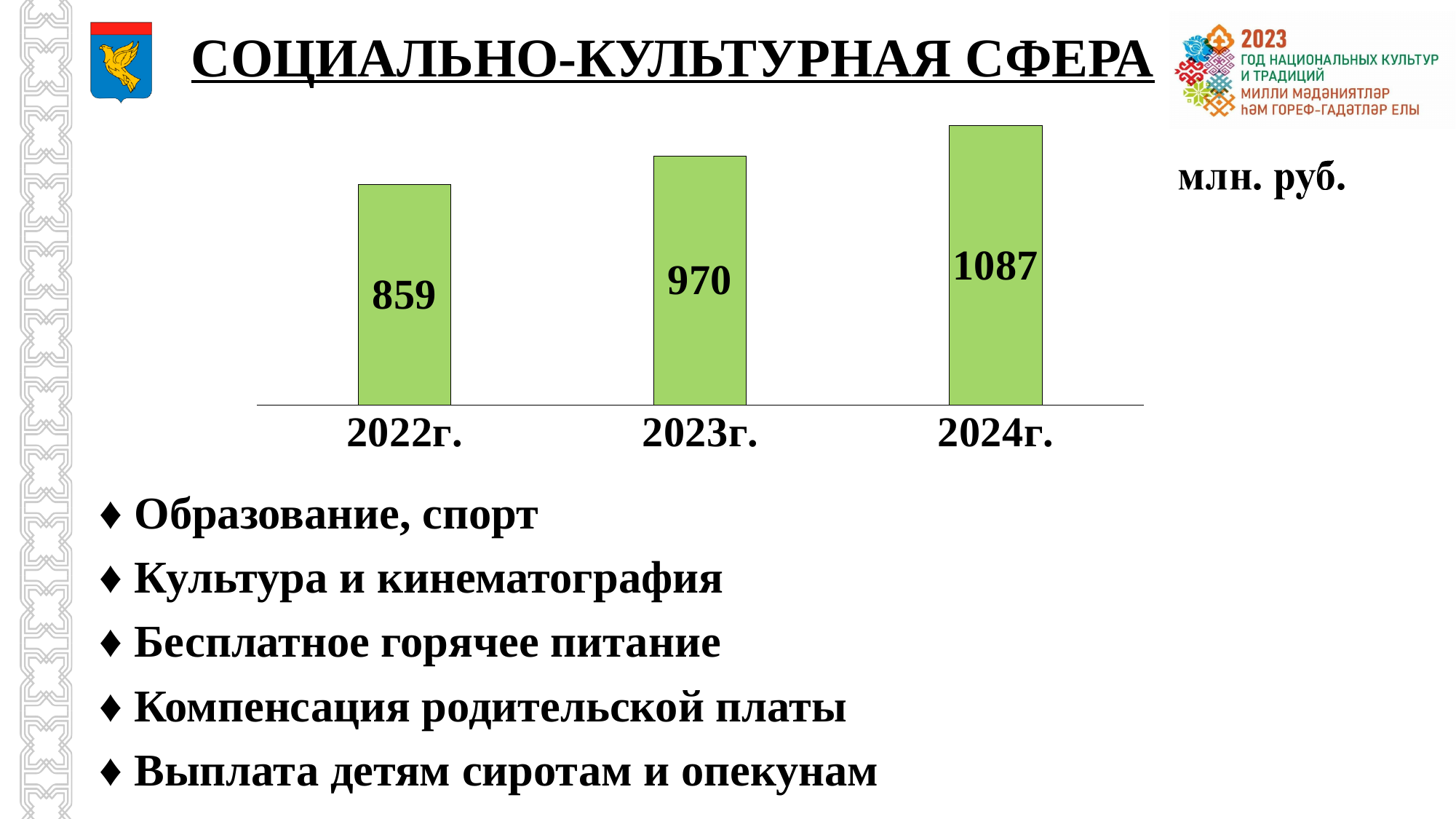
What is the value for 2022г.? 859 What unit is indicated next to the chart? млн. руб. How many years are shown on the chart? 3 Do the values rise or fall from 2022г. to 2024г.? rise What is the difference between the values for 2024г. and 2022г.? 228 What kind of chart is shown on the slide? bar chart Which is larger, the value for 2023г. or the value for 2024г.? 2024г. Which year has the lowest value? 2022г. Which year has the highest value? 2024г. What is the value for 2023г.? 970 What is the difference between the values for 2023г. and 2022г.? 111 What is the value for 2024г.? 1087